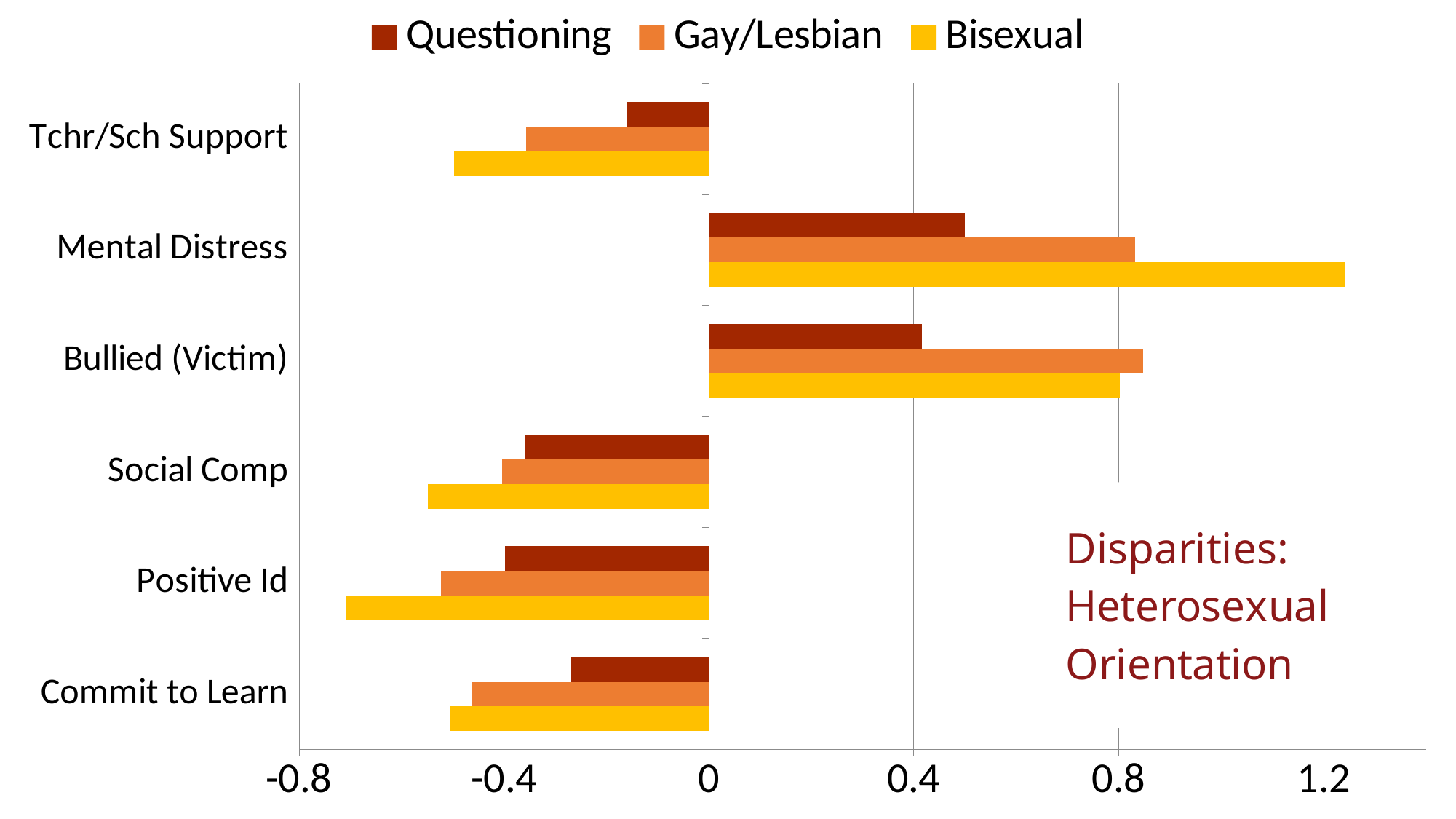
For Mental Distress, which is larger: the Bisexual value or the Gay/Lesbian value? Bisexual Is the Bisexual value for Positive Id greater or less than -0.4? less Is the Questioning value for Tchr/Sch Support greater or less than -0.4? greater For Bullied (Victim), which is larger: the Gay/Lesbian value or the Questioning value? Gay/Lesbian Which category has the highest Bisexual value? Mental Distress How many series does the legend list? 3 Which category has the lowest (most negative) Bisexual value? Positive Id What kind of chart is shown on the slide? bar chart Is the Bisexual value for Mental Distress greater or less than 1.2? greater Which series are listed in the legend? Questioning, Gay/Lesbian, Bisexual How many categories are shown on the vertical axis? 6